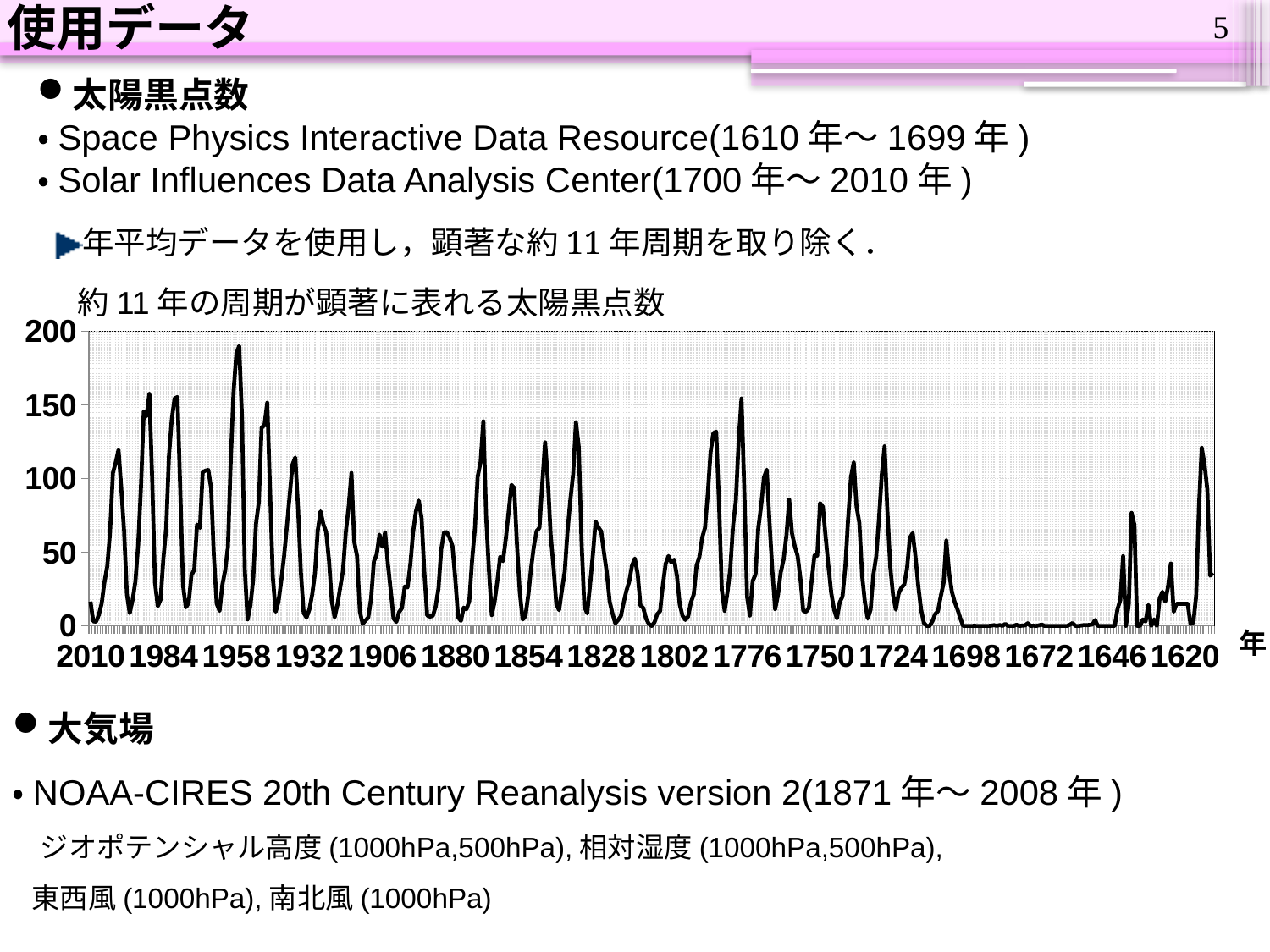
Is the peak of the line near the year 1776 greater or less than 100? greater Is the peak of the line near the year 1958 greater or less than 100? greater Is the highest peak of the line greater or less than 150? greater What is the rightmost year label on the x axis? 1620 What is the highest tick value shown on the y axis? 200 What is the title of the chart? 約11年の周期が顕著に表れる太陽黒点数 What kind of chart is shown on the slide? line chart What is the label shown at the right end of the x axis? 年 What is the leftmost year label on the x axis? 2010 Do the year labels on the x axis increase or decrease from left to right? decrease How many year labels are printed along the x axis? 16